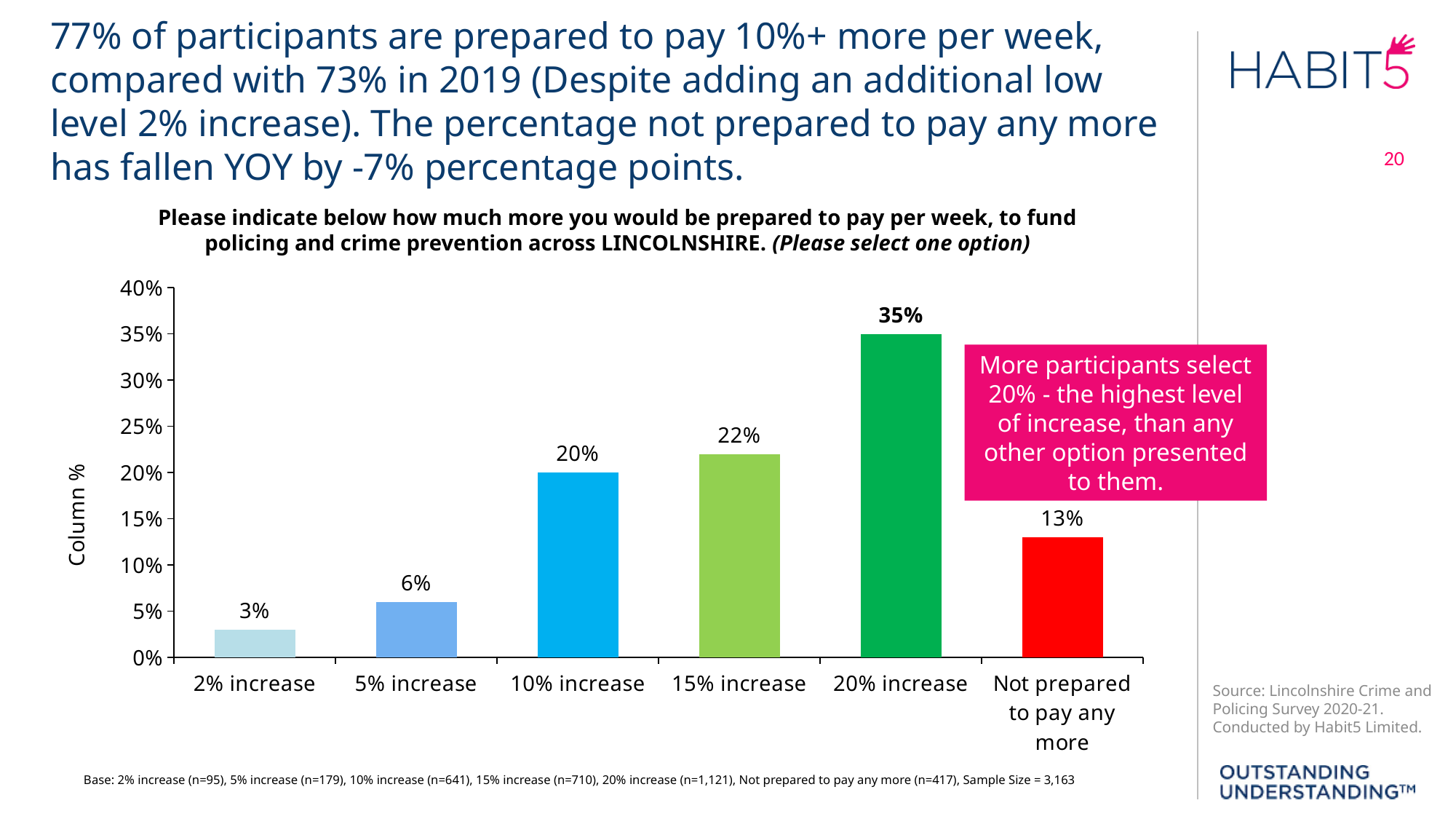
What is the difference in percentage points between the 20% increase and 15% increase categories? 13 Which category has the highest value? 20% increase What is the label on the y axis of the chart? Column % What type of chart is shown on the slide? Bar chart Which category has the lowest value? 2% increase What is the value for the 'Not prepared to pay any more' category? 13% How many categories are shown on the x axis? 6 Which is larger, the value for 10% increase or the value for 'Not prepared to pay any more'? 10% increase What percentage of participants selected a 2% increase? 3% What percentage of participants selected a 20% increase? 35% What is the difference in percentage points between the 10% increase and 5% increase categories? 14 What is the value for the 15% increase category? 22%